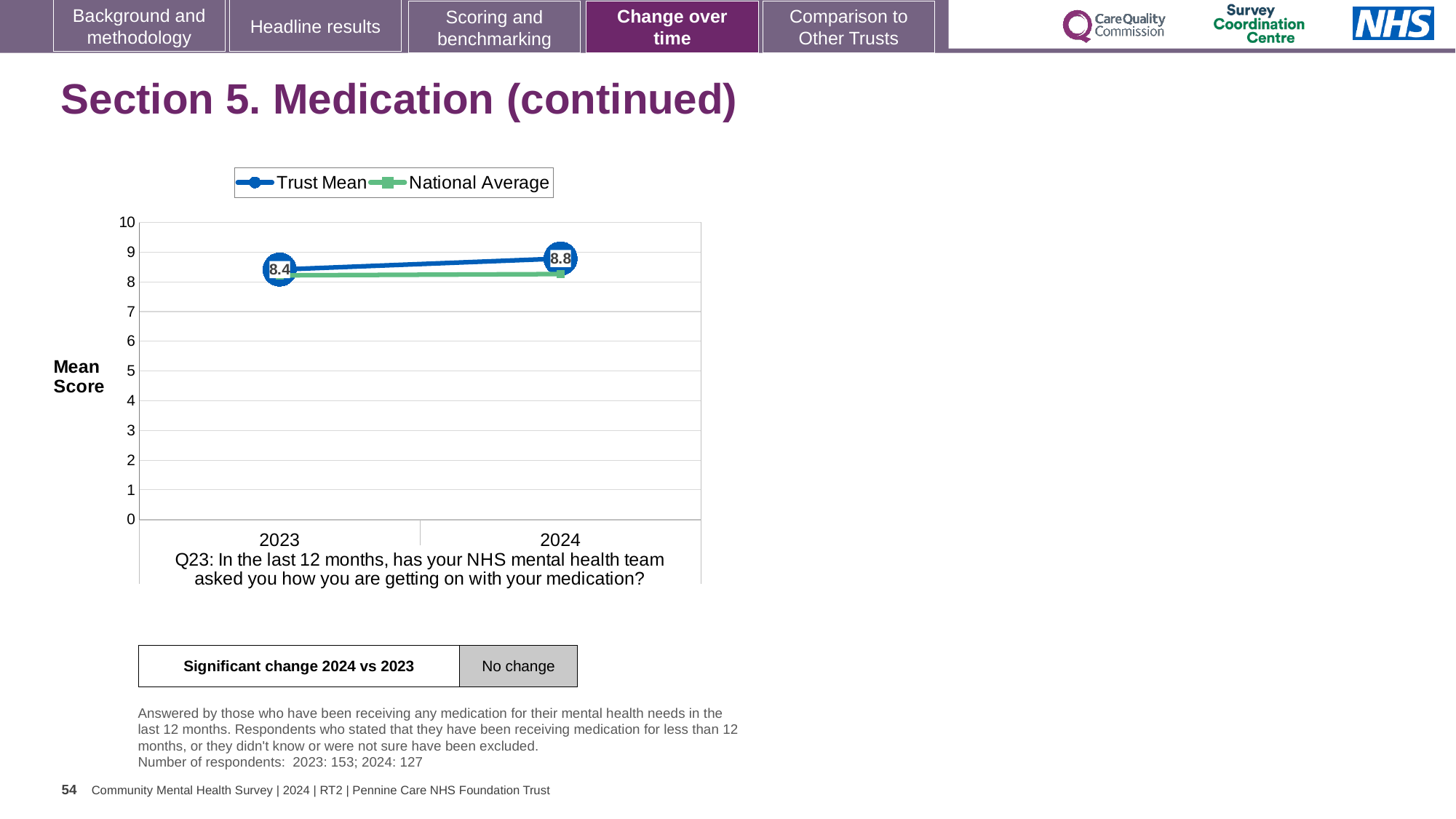
Is the National Average value for 2024 greater or less than 9? less Is the National Average value for 2023 greater or less than 7? greater In which year is the Trust Mean higher, 2023 or 2024? 2024 What is the Trust Mean value for 2023? 8.4 Does the Trust Mean rise or fall from 2023 to 2024? rise By how much did the Trust Mean change from 2023 to 2024? 0.4 How many years are shown on the x axis of the chart? 2 Which year has the highest Trust Mean? 2024 How many series does the legend list? 2 What kind of chart is shown on the slide? line chart What is the Trust Mean value for 2024? 8.8 In 2024, which is higher, the Trust Mean or the National Average? Trust Mean